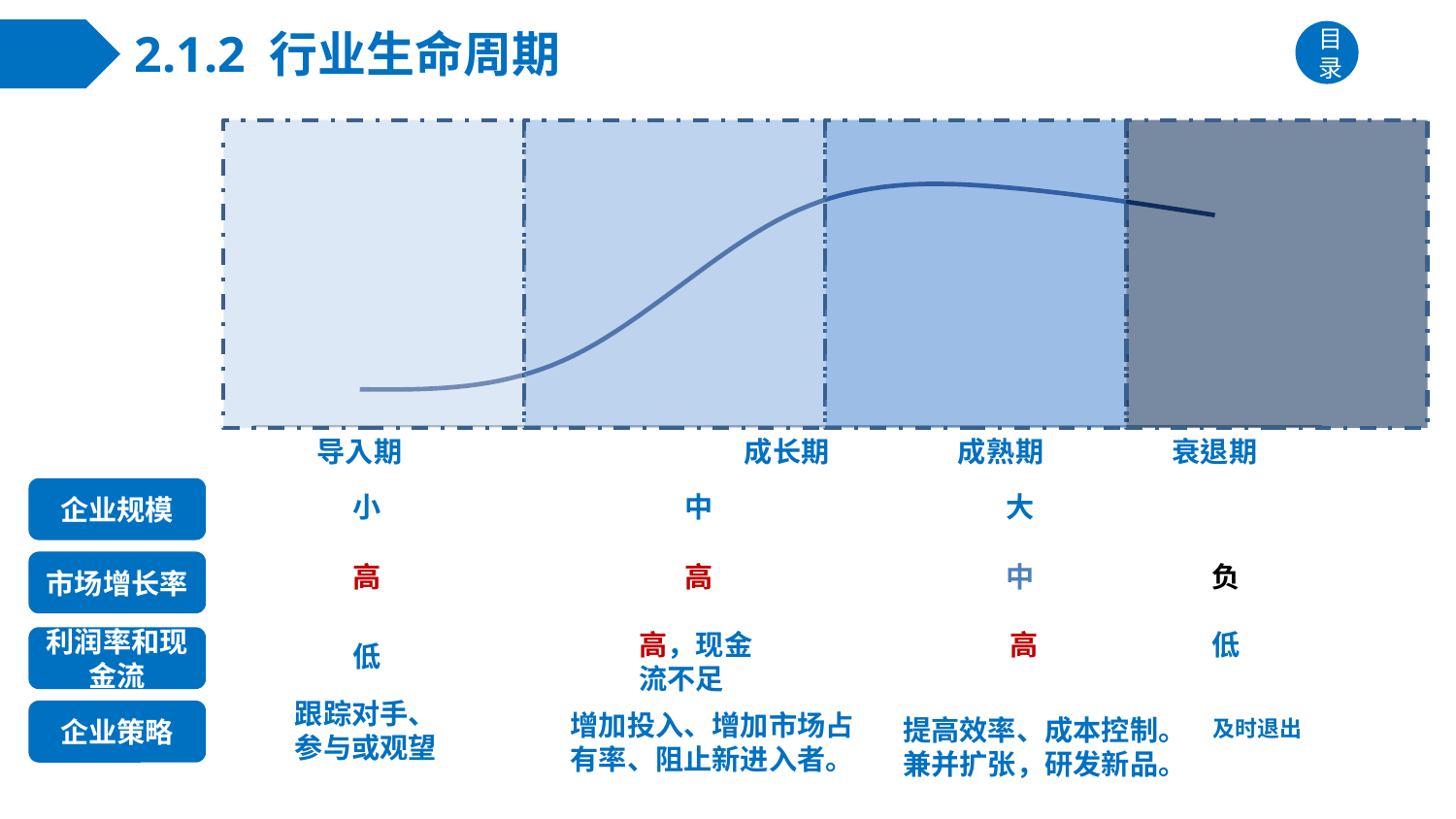
Does the curve rise or fall during the 衰退期 stage? fall What is the label of the last stage on the right of the chart? 衰退期 What is the title of the slide containing the chart? 2.1.2 行业生命周期 How many stages (shaded regions) does the life cycle chart divide the x axis into? 4 In which stage is the curve at its lowest level? 导入期 Is the curve higher in 成熟期 or in 导入期? 成熟期 What kind of chart is shown on the slide? line chart Is the curve roughly flat or steeply rising in the 导入期 stage? roughly flat In which stage does the curve reach its highest point? 成熟期 Does the curve rise or fall during the 成长期 stage? rise Which stage's shaded region is the darkest in colour? 衰退期 What is the label of the first stage on the left of the chart? 导入期